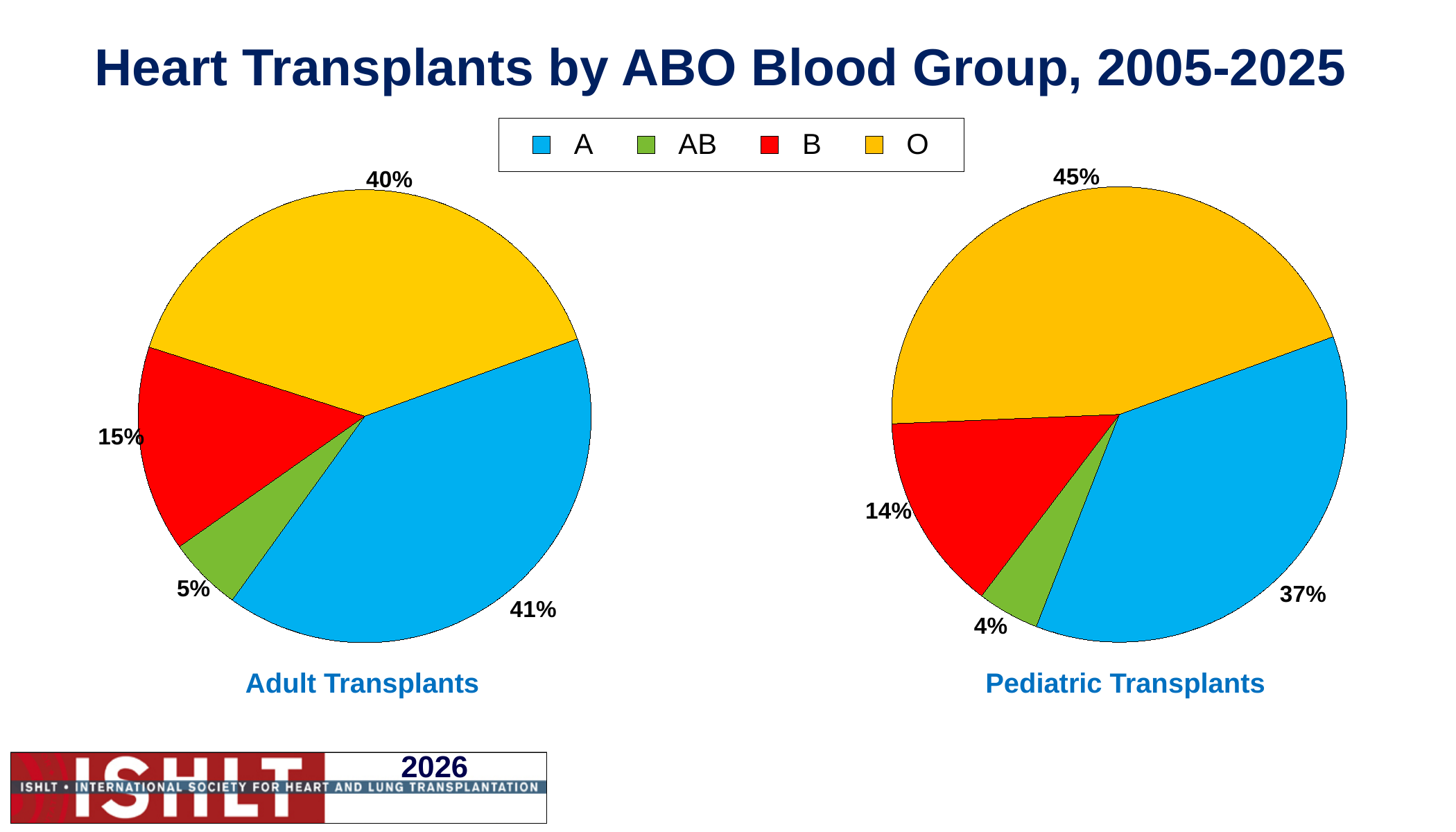
In the Pediatric Transplants pie chart, what share of heart transplants is blood group O? 45% In the Adult Transplants pie chart, what share of heart transplants is blood group A? 41% In the Pediatric Transplants pie chart, which blood group has the largest share? O How many blood groups does the legend list? 4 In the Pediatric Transplants pie chart, what percentage is shown for blood group B? 14% In the Adult Transplants pie chart, what percentage is shown for blood group AB? 5% Which colour represents blood group B in the legend? Red In the Adult Transplants pie chart, which is larger: the share for blood group A or blood group O? A In the Adult Transplants pie chart, which blood group has the smallest share? AB In the Adult Transplants pie chart, what is the difference between the shares for blood group O and blood group B? 25% What type of chart is used for the Adult Transplants and Pediatric Transplants data? Pie chart In the Pediatric Transplants pie chart, what is the difference between the shares for blood group A and blood group AB? 33%